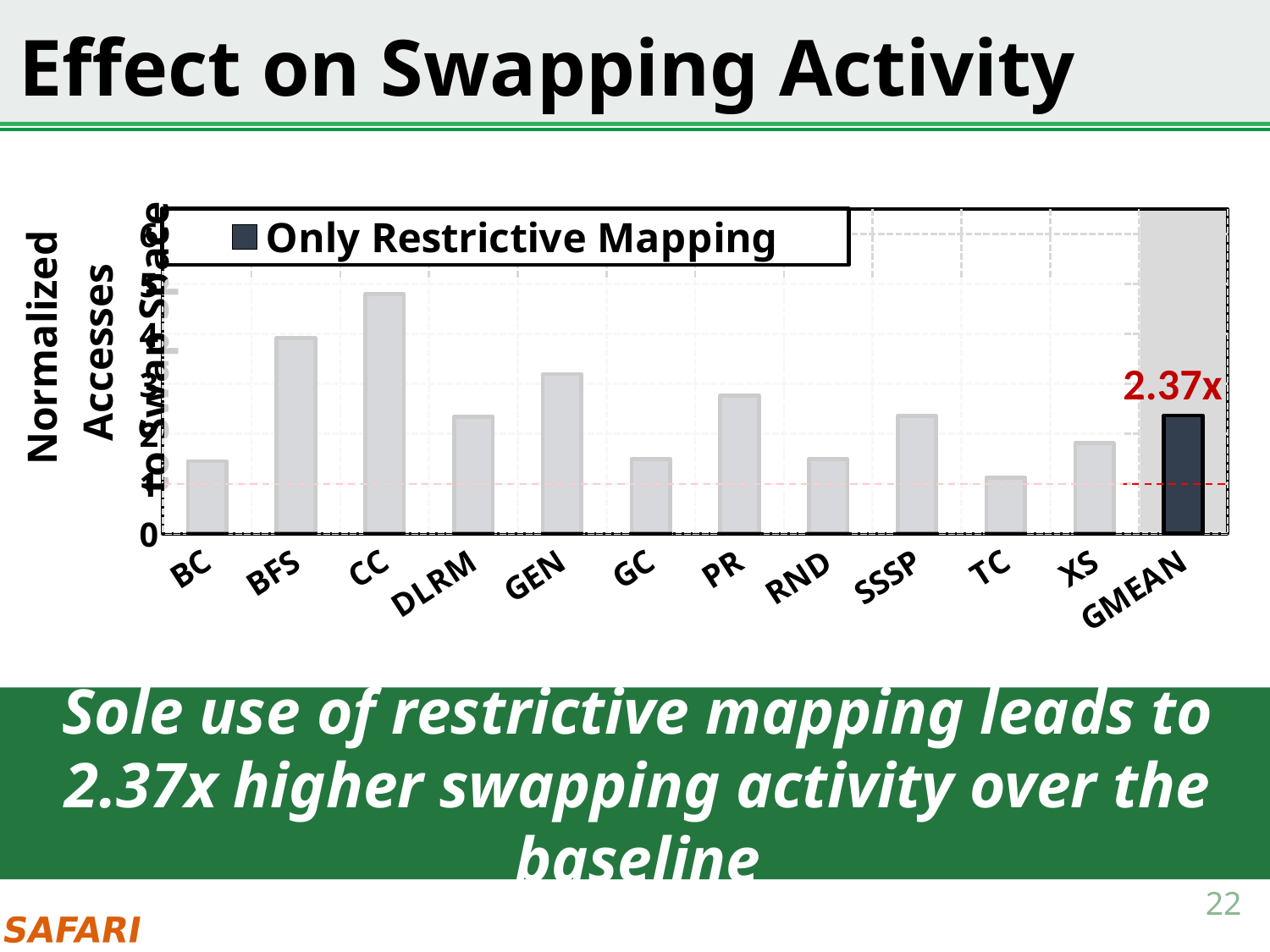
Which has a higher value, CC or BFS? CC What is the value labeled on the GMEAN bar? 2.37x How many categories are shown on the x axis? 12 Which category has the lowest bar? TC What is the series name shown in the legend? Only Restrictive Mapping Which category has the highest bar? CC Which has a higher value, XS or TC? XS Which has a higher value, PR or RND? PR What type of chart is shown on the slide? bar chart How many series does the legend list? 1 What is the title of the slide containing the chart? Effect on Swapping Activity